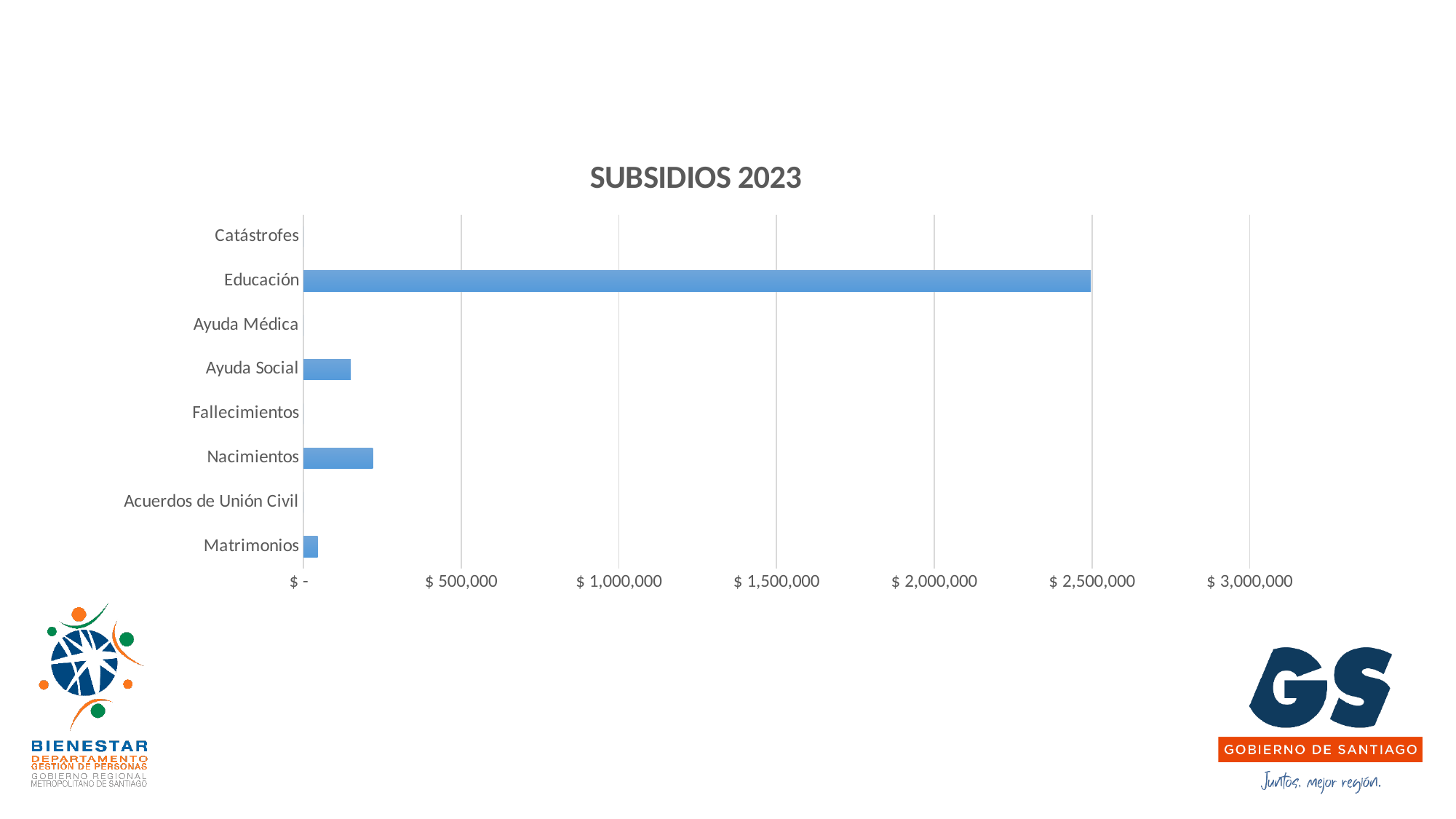
Which has a larger value, Nacimientos or Ayuda Social? Nacimientos Which has a larger value, Ayuda Social or Matrimonios? Ayuda Social Which has a larger value, Educación or Nacimientos? Educación How many categories are listed on the vertical axis of the chart? 8 How many categories in the chart show no visible bar? 4 Is the value for Matrimonios greater or less than $ 500,000? less Which category has the highest value in the chart? Educación What kind of chart is shown on the slide? Bar chart Is the value for Nacimientos greater or less than $ 500,000? less Is the value for Educación greater or less than $ 2,000,000? greater What is the title of the chart? SUBSIDIOS 2023